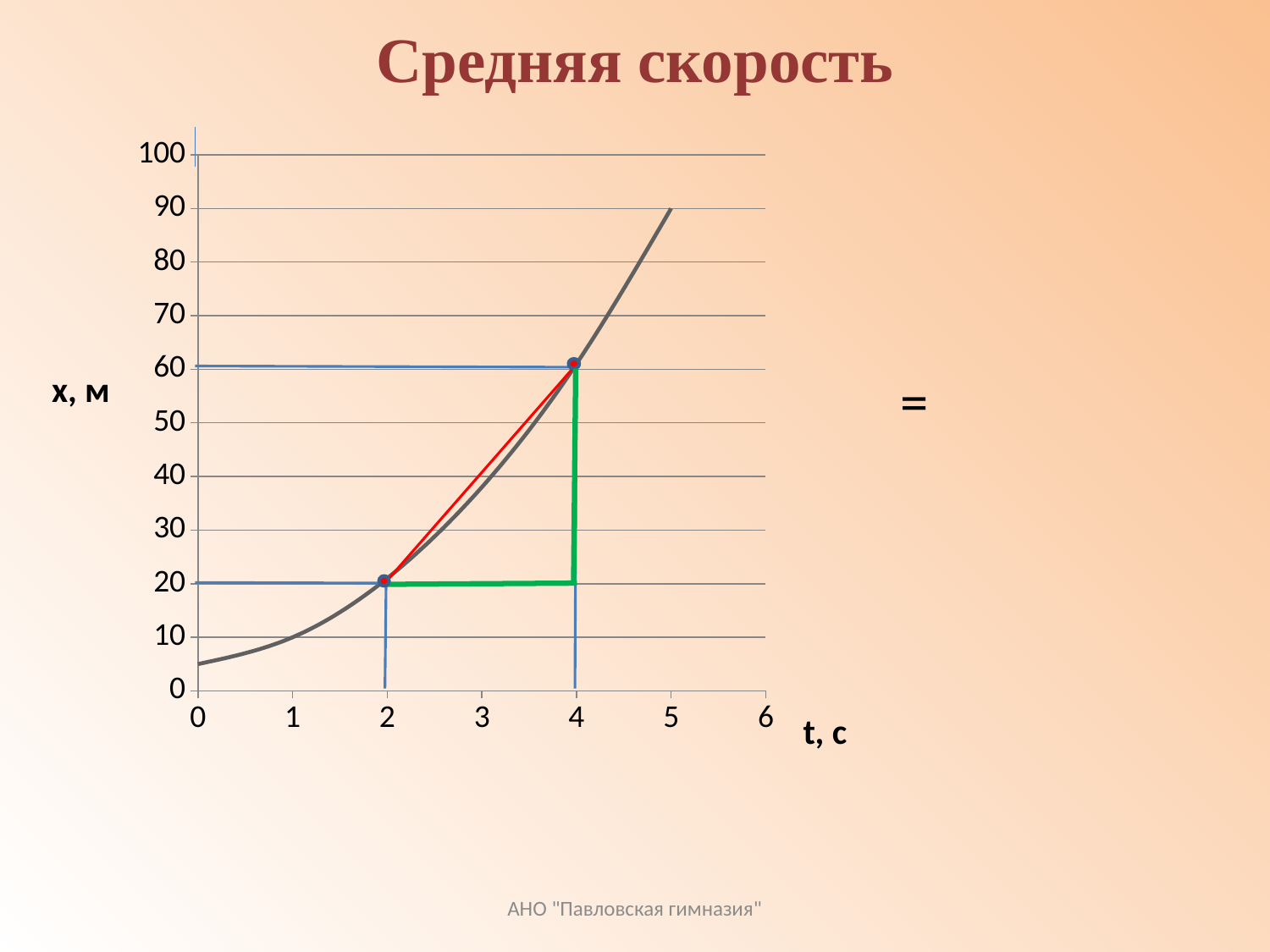
Is the value of x at t = 0 greater or less than 10? less How many points are marked with dots on the curve? 2 What kind of chart is shown on the slide? line chart Is the value of x at t = 1 greater or less than 20? less What is the title of the slide? Средняя скорость Is the value of x at t = 5 greater or less than 80? greater Does x rise or fall as t increases along the chart? rises Which is larger: the value of x at t = 4 or at t = 2? t = 4